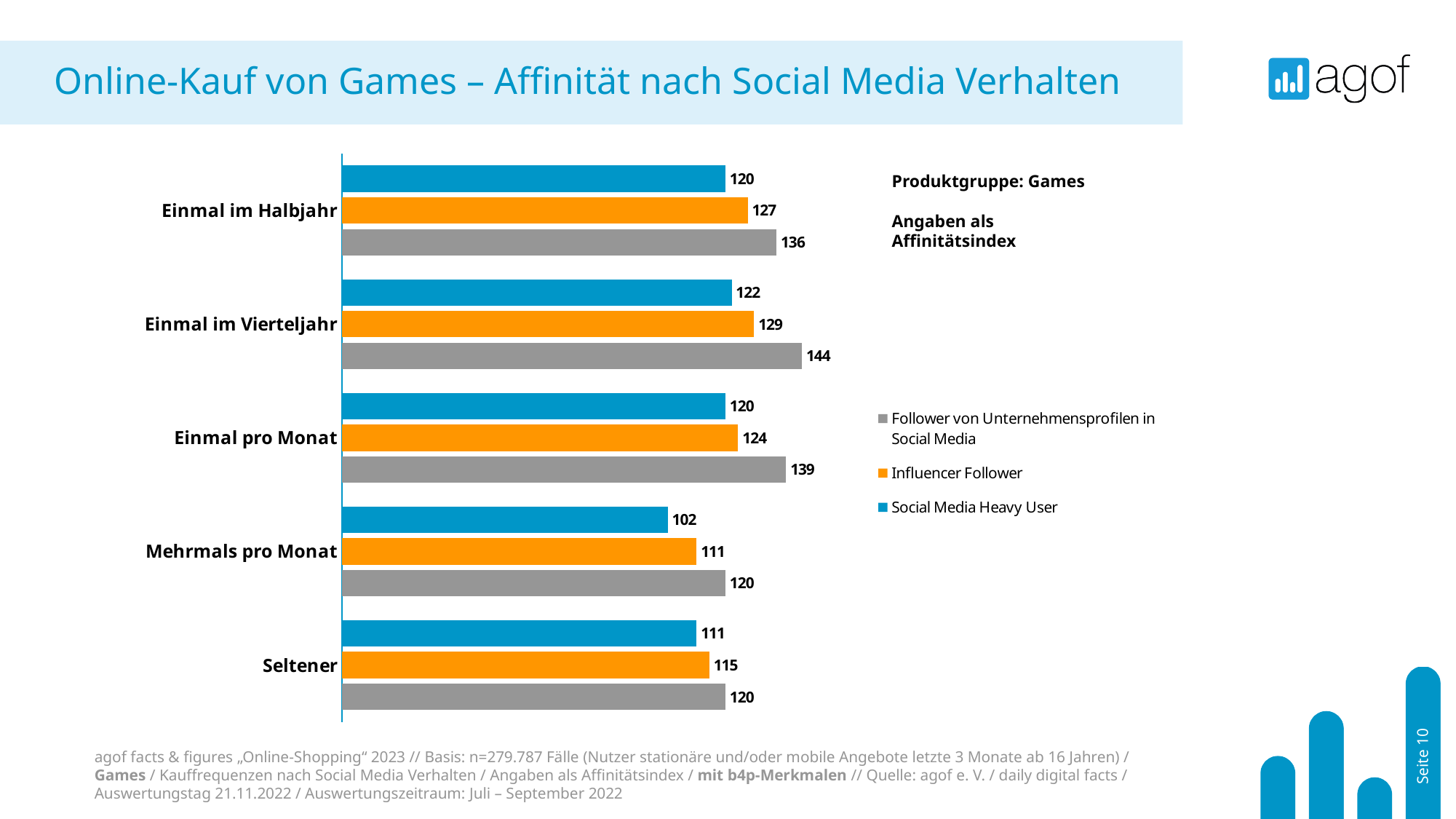
Which category has the highest value for Follower von Unternehmensprofilen in Social Media? Einmal im Vierteljahr What is the value for Social Media Heavy User in the category Mehrmals pro Monat? 102 How many categories are shown on the chart? 5 What is the value for Follower von Unternehmensprofilen in Social Media in the category Einmal pro Monat? 139 How many series does the legend list? 3 What is the value for Influencer Follower in the category Einmal im Vierteljahr? 129 In the category Seltener, which is larger: the Influencer Follower value or the Social Media Heavy User value? Influencer Follower What is the difference between the Influencer Follower values for Einmal im Halbjahr and Mehrmals pro Monat? 16 What kind of chart is shown on the slide? Bar chart Which colour represents the Influencer Follower series in the legend? Orange Which category has the lowest value for Social Media Heavy User? Mehrmals pro Monat What is the difference between the Follower von Unternehmensprofilen in Social Media value and the Social Media Heavy User value in the category Einmal im Vierteljahr? 22